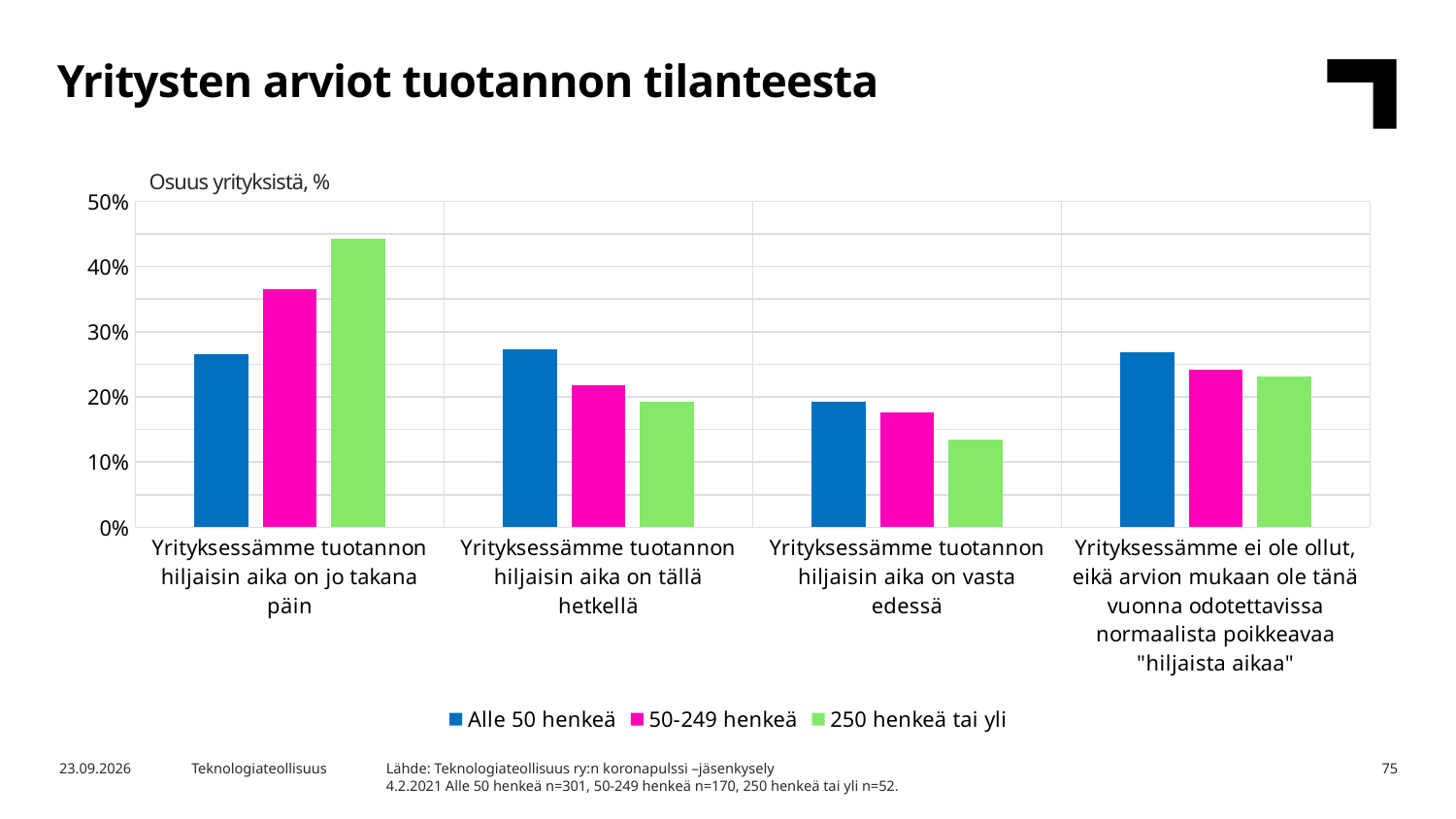
What is the label shown above the vertical axis? Osuus yrityksistä, % Is the value for "250 henkeä tai yli" in the category "Yrityksessämme tuotannon hiljaisin aika on jo takana päin" greater or less than 40%? greater In the category "Yrityksessämme tuotannon hiljaisin aika on jo takana päin", which series has the highest value? 250 henkeä tai yli Is the value for "50-249 henkeä" in the category "Yrityksessämme tuotannon hiljaisin aika on jo takana päin" greater or less than 30%? greater What kind of chart is shown on the slide? Bar chart Is the value for "50-249 henkeä" in the category "Yrityksessämme tuotannon hiljaisin aika on vasta edessä" greater or less than 20%? less In the category "Yrityksessämme tuotannon hiljaisin aika on tällä hetkellä", which is larger: "Alle 50 henkeä" or "50-249 henkeä"? Alle 50 henkeä How many categories are shown on the x axis? 4 Which series has the lowest value in the category "Yrityksessämme tuotannon hiljaisin aika on vasta edessä"? 250 henkeä tai yli What are the three series listed in the legend? Alle 50 henkeä, 50-249 henkeä, 250 henkeä tai yli How many series does the legend list? 3